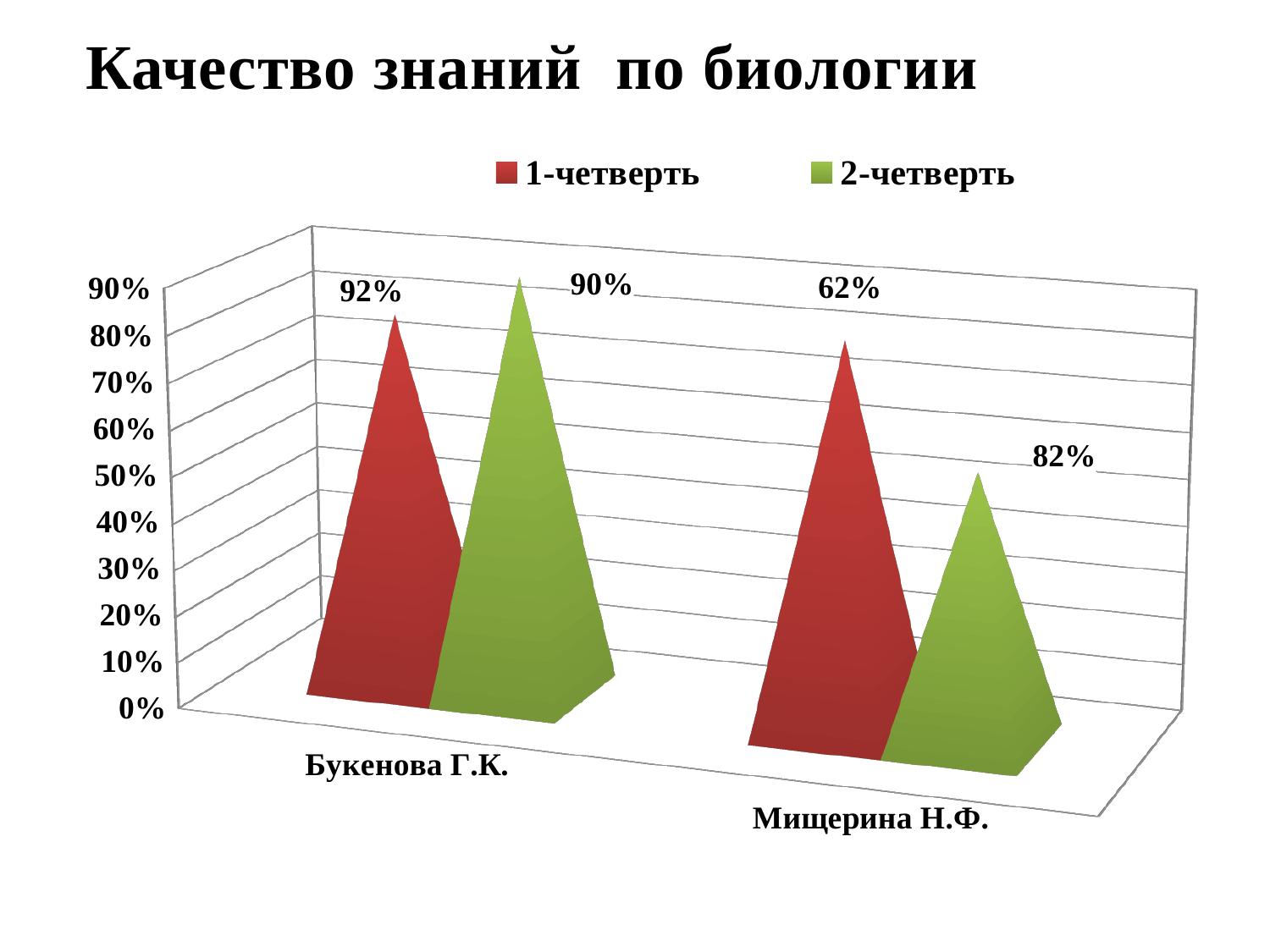
How many teachers (categories) are shown on the x axis? 2 What is the difference between the 1-четверть values for Букенова Г.К. and Мищерина Н.Ф.? 30% For Мищерина Н.Ф., which series has the larger value, 1-четверть or 2-четверть? 2-четверть What is the value for Букенова Г.К. in the 2-четверть series? 90% How many series does the legend list? 2 Which teacher has the highest value in the 2-четверть series? Букенова Г.К. What is the title of the chart? Качество знаний по биологии What is the value for Букенова Г.К. in the 1-четверть series? 92% What is the value for Мищерина Н.Ф. in the 1-четверть series? 62% Which teacher has the lowest value in the 1-четверть series? Мищерина Н.Ф. What is the difference between the 1-четверть and 2-четверть values for Мищерина Н.Ф.? 20% What is the value for Мищерина Н.Ф. in the 2-четверть series? 82%